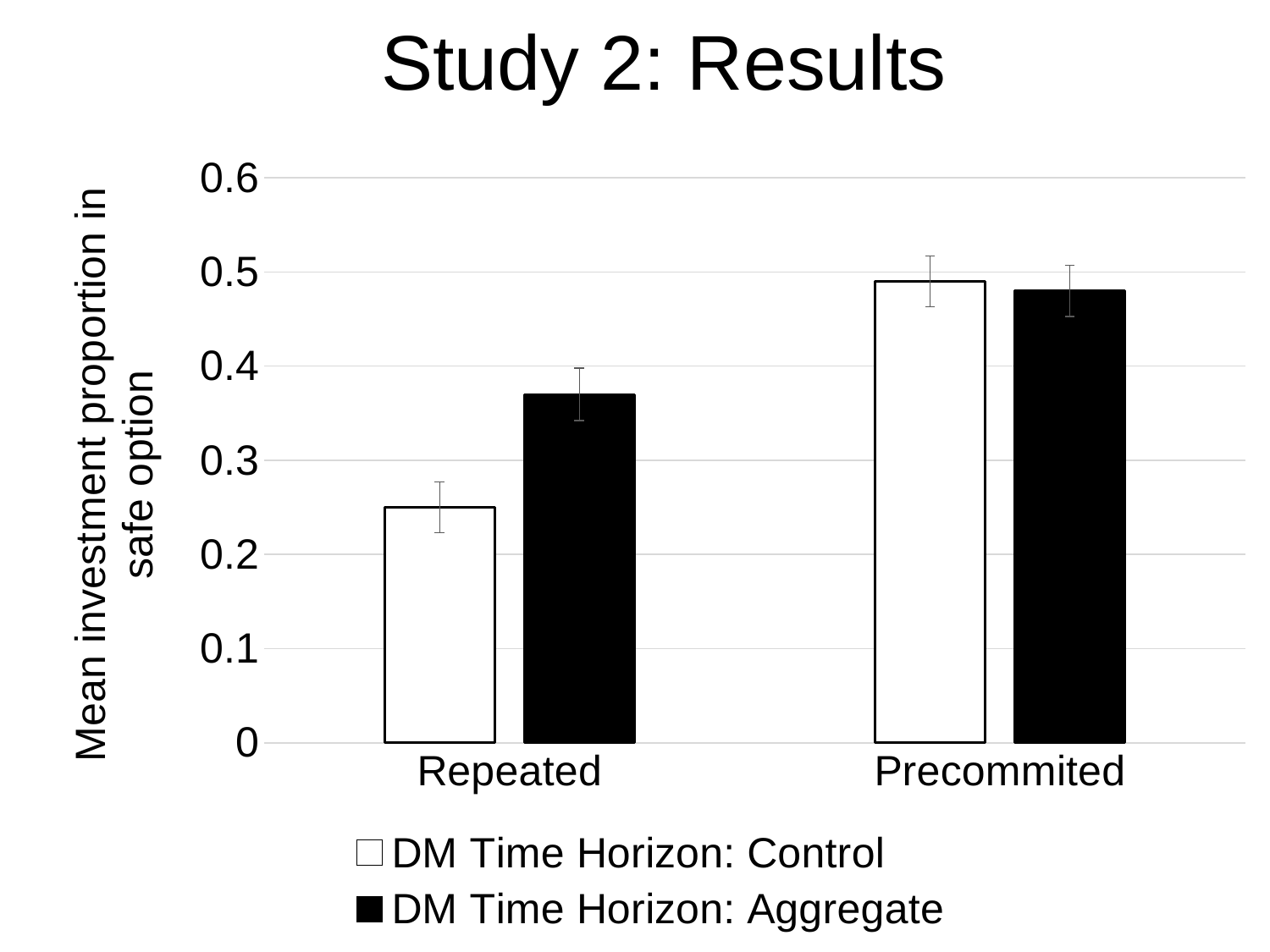
For the DM Time Horizon: Control series, which category has the higher value? Precommited What is the title of the slide? Study 2: Results Is the value for DM Time Horizon: Aggregate in the Repeated category greater or less than 0.3? greater How many series does the legend list? 2 Is the value for DM Time Horizon: Aggregate in the Precommited category greater or less than 0.4? greater For the DM Time Horizon: Aggregate series, which is larger: Repeated or Precommited? Precommited In the Repeated category, which series has the larger value: DM Time Horizon: Control or DM Time Horizon: Aggregate? DM Time Horizon: Aggregate Which bar is the lowest in the chart? Repeated, DM Time Horizon: Control What kind of chart is shown on the slide? bar chart How many categories are shown on the x axis? 2 What is the label of the y axis? Mean investment proportion in safe option Is the value for DM Time Horizon: Control in the Repeated category greater or less than 0.3? less